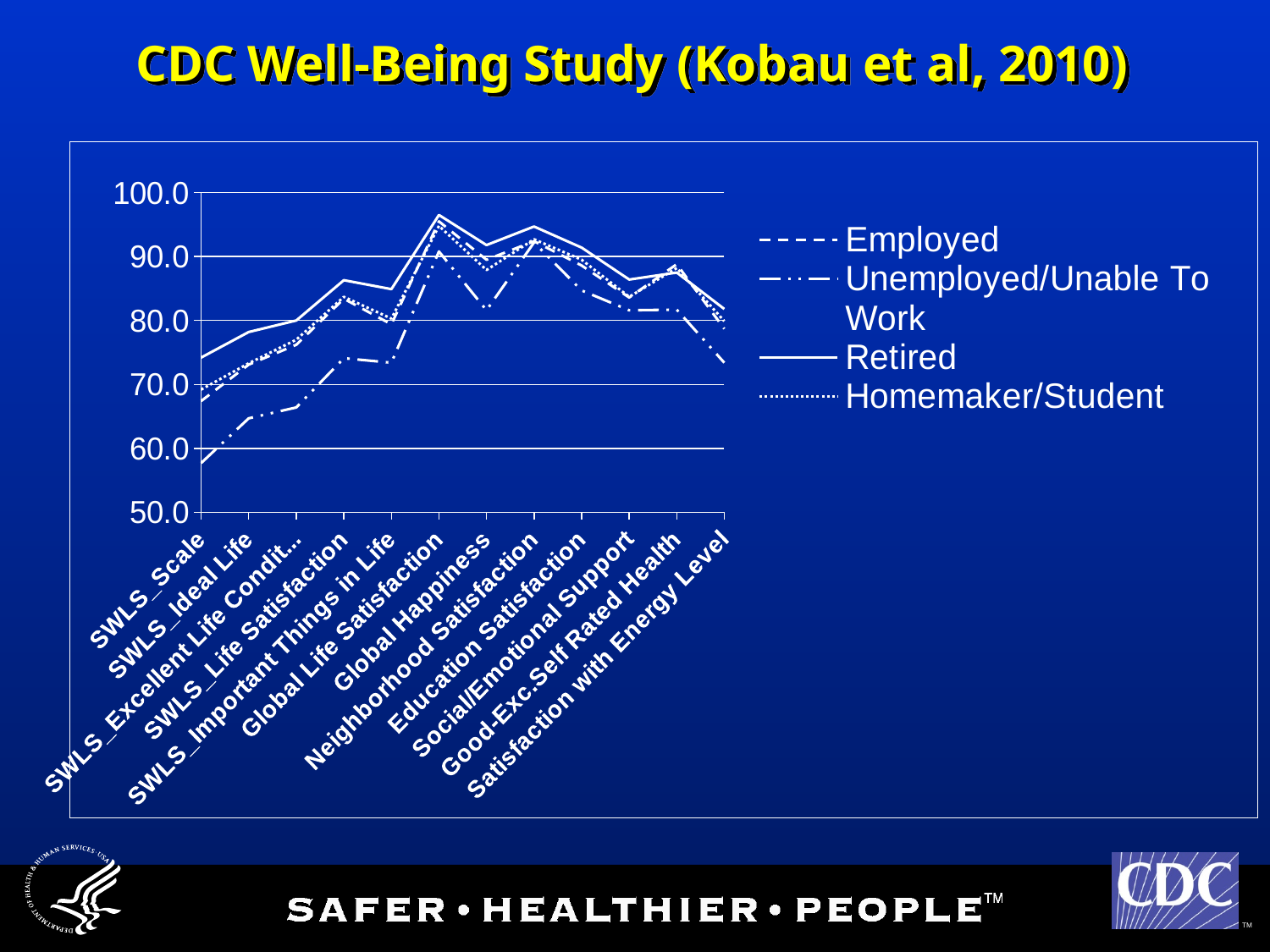
Is the value for Retired at SWLS_Scale greater or less than 70? greater Is the value for Retired at Global Life Satisfaction greater or less than 90? greater How many series does the legend list? 4 Is the value for Unemployed/Unable To Work at Satisfaction with Energy Level greater or less than 80? less At SWLS_Scale, which is larger: the Retired value or the Unemployed/Unable To Work value? Retired For the Unemployed/Unable To Work series, which category has the lowest value? SWLS_Scale At SWLS_Scale, which series has the lowest value? Unemployed/Unable To Work Which series is drawn with a solid line in the legend? Retired What kind of chart is shown on the slide? Line chart What is the title of the slide containing the chart? CDC Well-Being Study (Kobau et al, 2010) How many categories are plotted along the x axis? 12